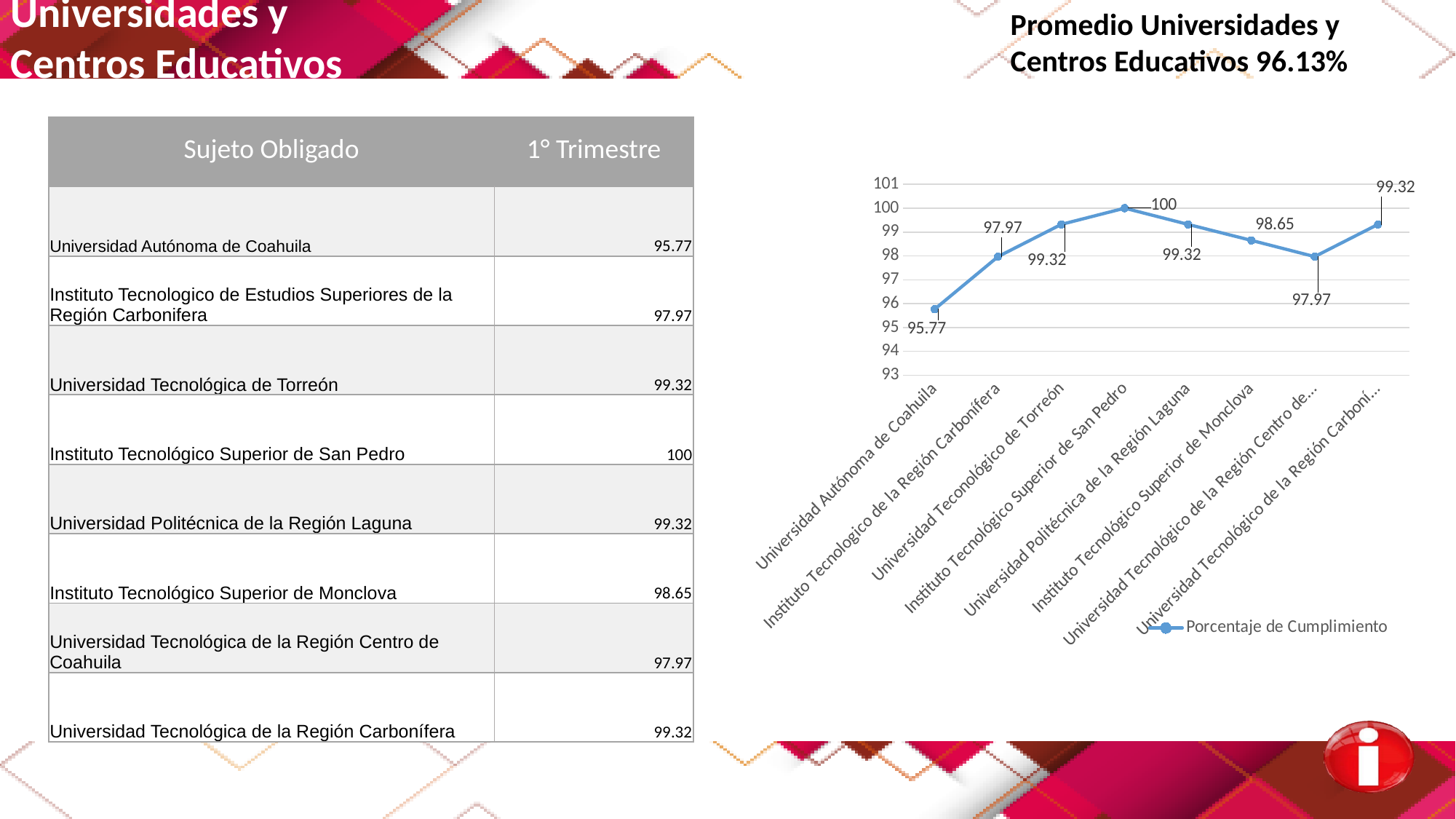
How many series does the chart legend list? 1 How many data points are plotted in the chart? 8 Which category has the lowest value in the chart? Universidad Autónoma de Coahuila Which category has the highest value in the chart? Instituto Tecnológico Superior de San Pedro What type of chart is shown on the slide? line chart What is the name of the series shown in the chart legend? Porcentaje de Cumplimiento What is the difference between the values for Instituto Tecnológico Superior de San Pedro and Universidad Autónoma de Coahuila? 4.23 Which is larger: the value for Instituto Tecnológico Superior de Monclova or the value for Universidad Politécnica de la Región Laguna? Universidad Politécnica de la Región Laguna What is the value for Instituto Tecnológico Superior de San Pedro in the chart? 100 What is the value for Universidad Teconológico de Torreón in the chart? 99.32 What is the value for Instituto Tecnológico Superior de Monclova in the chart? 98.65 What is the value for Universidad Autónoma de Coahuila in the chart? 95.77